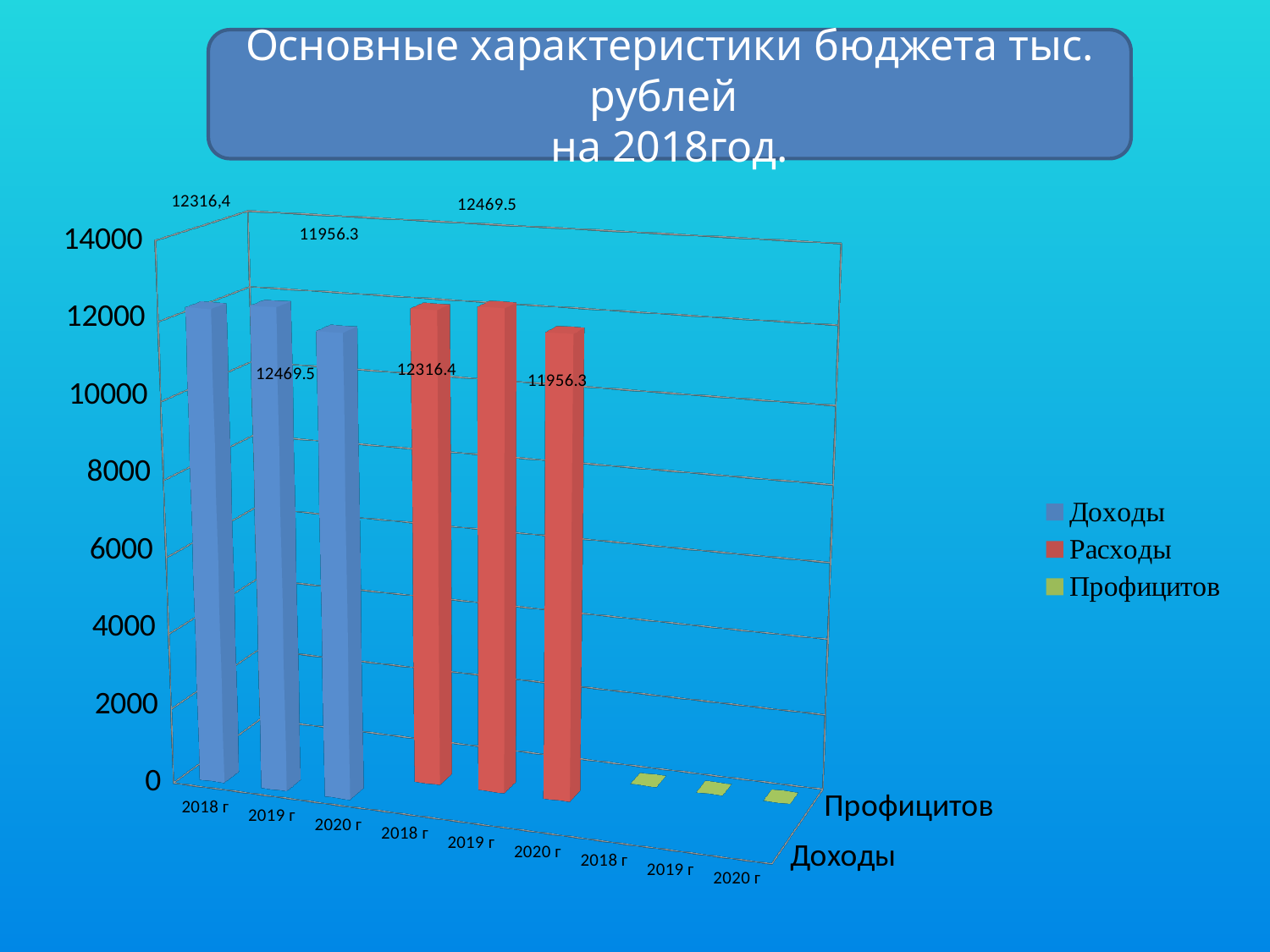
What is the value of Доходы for 2020 г? 11956.3 How many series does the legend list? 3 How many years are plotted for the Доходы series? 3 Which year has the lowest Доходы value? 2020 г Is the value of Профицитов for 2018 г greater or less than 2000? less Which is larger, Доходы for 2018 г or Профицитов for 2018 г? Доходы for 2018 г What is the value of Расходы for 2020 г? 11956.3 What are the three series named in the legend? Доходы, Расходы, Профицитов What kind of chart is shown on the slide? bar chart Which year has the lowest Расходы value? 2020 г What colour are the Расходы bars? red Is the value of Доходы for 2020 г greater or less than 10000? greater